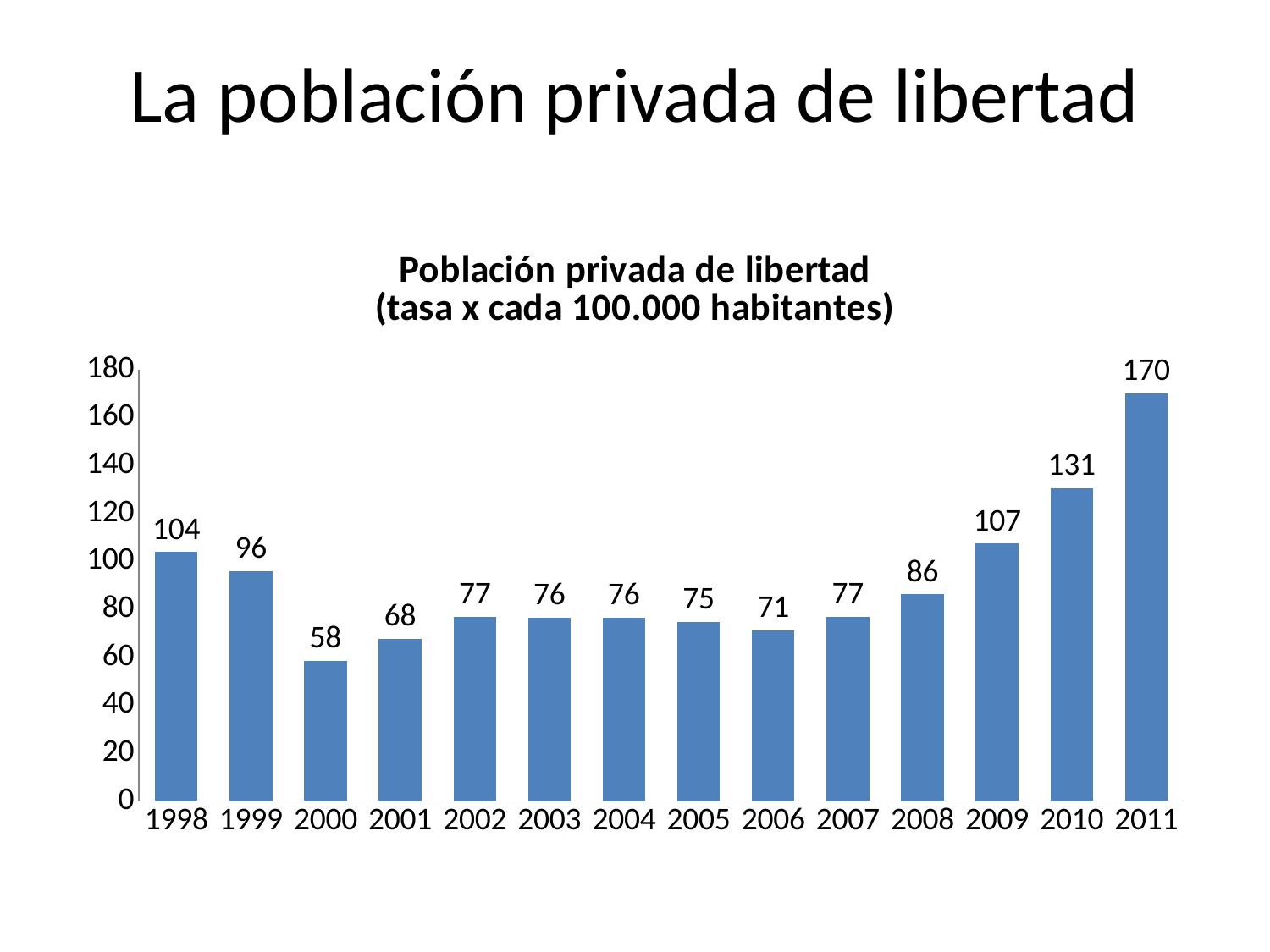
What kind of chart is shown? bar chart Is the value for 2010 greater or less than 120? greater What is the difference between the values for 1998 and 1999? 8 What is the difference between the values for 2011 and 2010? 39 Which year has the highest value? 2011 What is the value for 2000? 58 How many years are shown on the x axis? 14 Which is larger, the value for 2009 or the value for 1998? 2009 Do the values rise or fall from 2006 to 2011? rise Which year has the lowest value? 2000 What is the value for 2008? 86 What is the value for 2011? 170